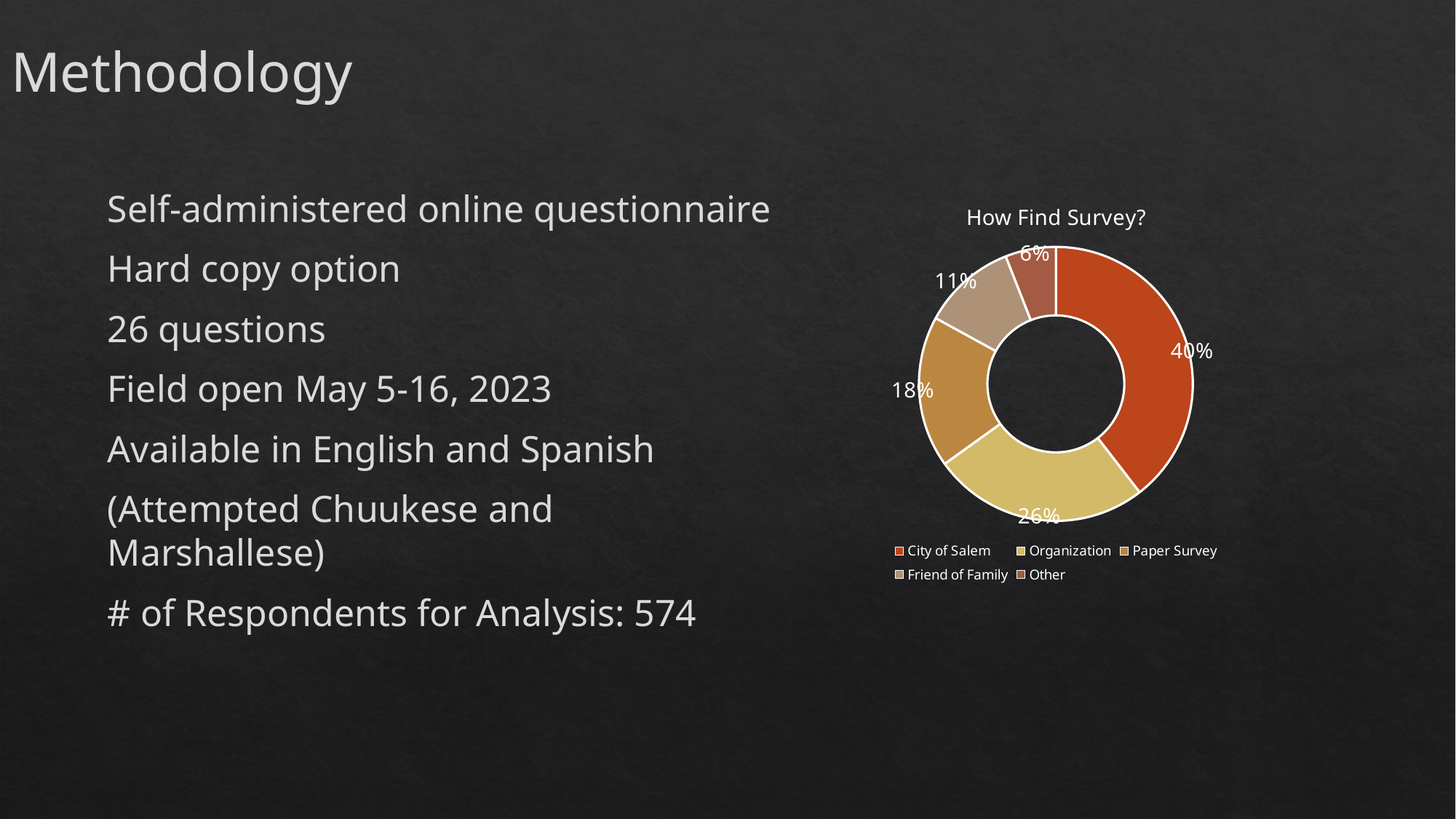
What percentage is shown for Paper Survey? 18% What is the title of the chart? How Find Survey? What kind of chart is shown on the slide? doughnut chart How many categories does the legend list? 5 What percentage of respondents found the survey through the City of Salem? 40% What percentage of respondents found the survey through an Organization? 26% What is the difference in percentage points between City of Salem and Organization? 14 What percentage is shown for Friend of Family? 11% Which category has the smallest share of the chart? Other Which category has the largest share of the chart? City of Salem Which is larger, the share for Paper Survey or the share for Friend of Family? Paper Survey What percentage is shown for Other? 6%